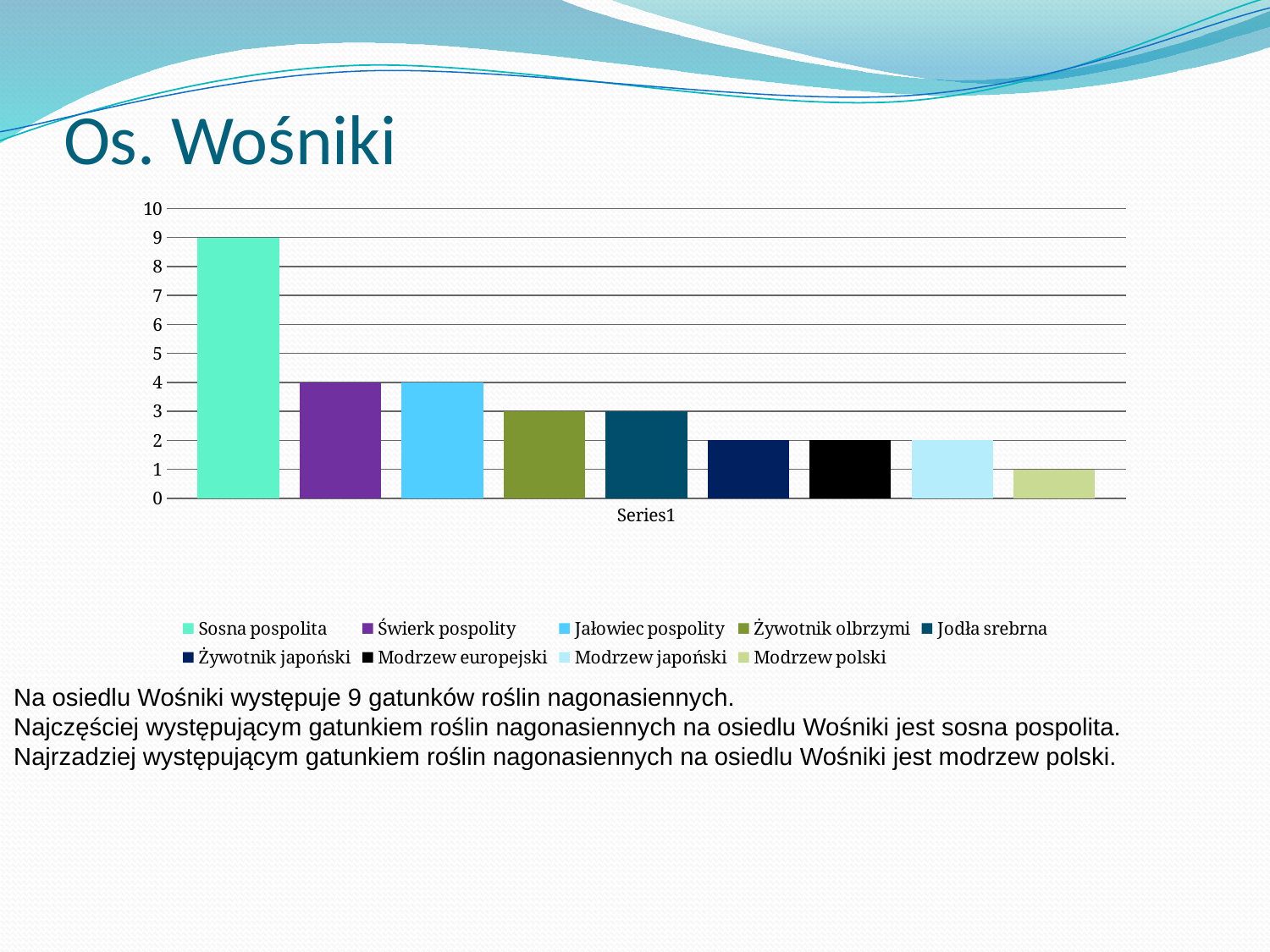
What type of chart is shown on the slide? bar chart What is the difference between the values for Sosna pospolita and Świerk pospolity? 5 What is the label shown under the bars on the x axis? Series1 What is the value for Sosna pospolita? 9 How many bars are plotted in the chart? 9 Which is larger, the value for Jodła srebrna or the value for Modrzew japoński? Jodła srebrna Which species has the lowest bar? Modrzew polski What is the value for Modrzew polski? 1 Is the value for Sosna pospolita greater or less than 5? greater Which species has the highest bar? Sosna pospolita How many entries does the legend list? 9 What is the value for Żywotnik olbrzymi? 3